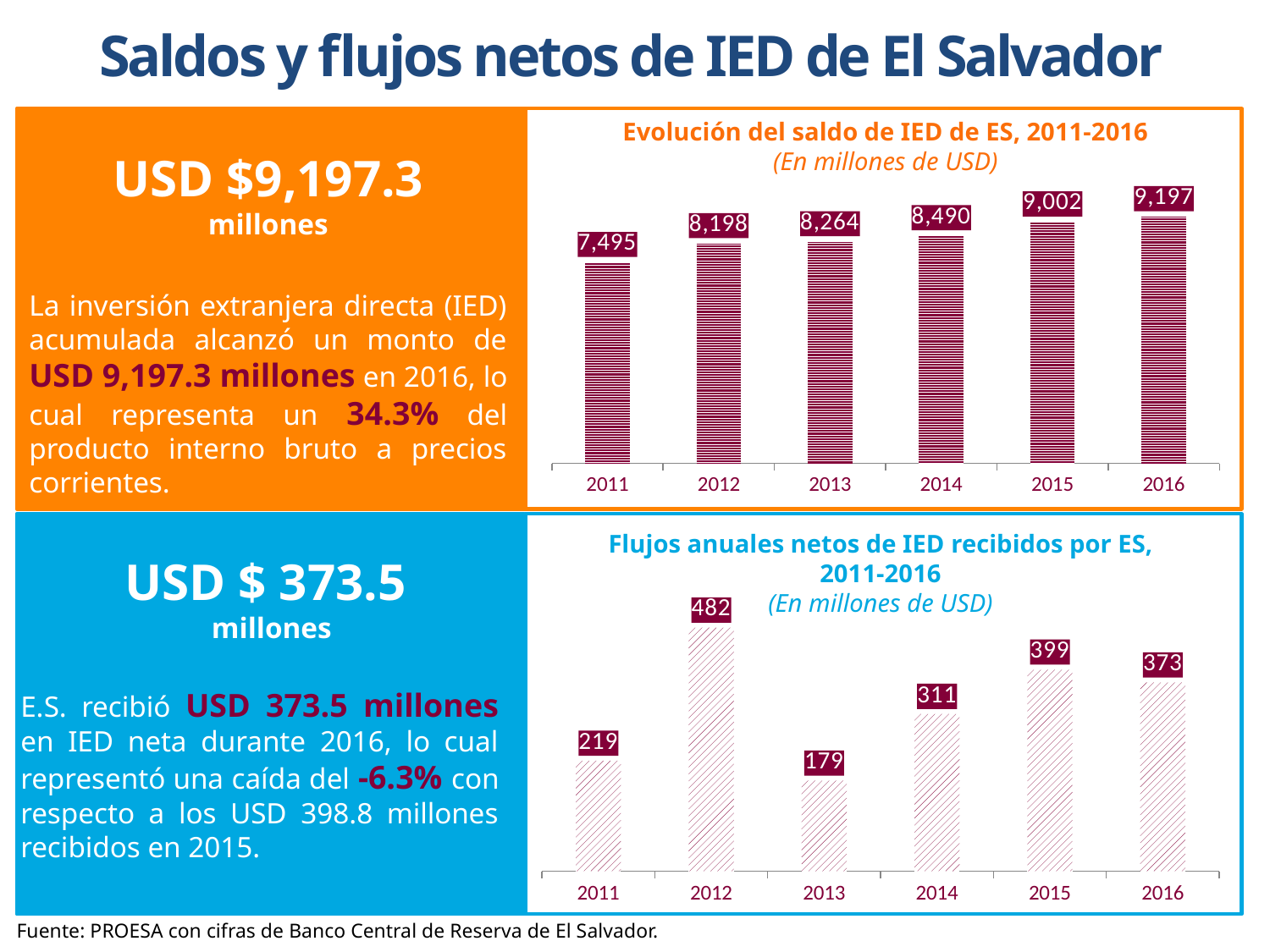
In the chart 'Flujos anuales netos de IED recibidos por ES, 2011-2016', what is the value for 2014? 311 In the chart 'Evolución del saldo de IED de ES, 2011-2016', which year has the lowest value? 2011 How many years are shown in the chart 'Evolución del saldo de IED de ES, 2011-2016'? 6 In the chart 'Flujos anuales netos de IED recibidos por ES, 2011-2016', which year has the highest value? 2012 In the chart 'Flujos anuales netos de IED recibidos por ES, 2011-2016', which is larger, the value for 2011 or the value for 2013? 2011 In the chart 'Evolución del saldo de IED de ES, 2011-2016', do the values rise or fall from 2011 to 2016? rise What unit is stated in the subtitle of the chart 'Flujos anuales netos de IED recibidos por ES, 2011-2016'? En millones de USD In the chart 'Flujos anuales netos de IED recibidos por ES, 2011-2016', which year has the lowest value? 2013 What type of chart is the 'Evolución del saldo de IED de ES, 2011-2016' chart? bar chart In the chart 'Evolución del saldo de IED de ES, 2011-2016', what is the difference between the 2016 and 2011 values? 1,702 In the chart 'Evolución del saldo de IED de ES, 2011-2016', what is the value for 2013? 8,264 In the chart 'Flujos anuales netos de IED recibidos por ES, 2011-2016', what is the difference between the 2015 and 2016 values? 26